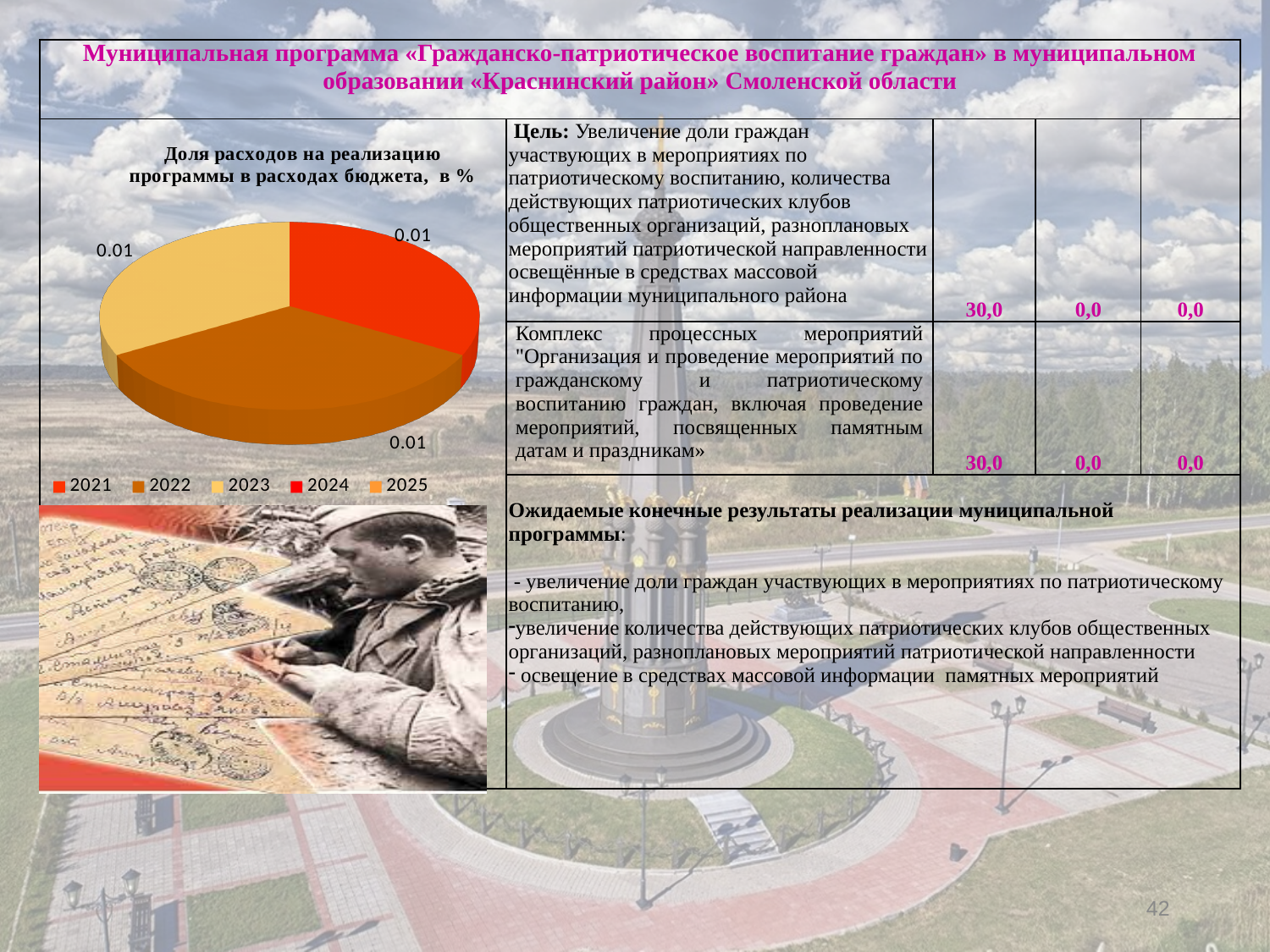
What value is labelled on the pie slice for 2023? 0.01 What kind of chart is shown on the slide? pie chart Which years are listed in the legend of the pie chart? 2021, 2022, 2023, 2024, 2025 What value is labelled on the pie slice for 2021? 0.01 What value is labelled on the pie slice for 2022? 0.01 What is the title of the pie chart? Доля расходов на реализацию программы в расходах бюджета, в % How many slices with data labels are visible in the pie chart? 3 What is the difference between the labelled values for 2021 and 2023 in the pie chart? 0 How many entries does the legend of the pie chart list? 5